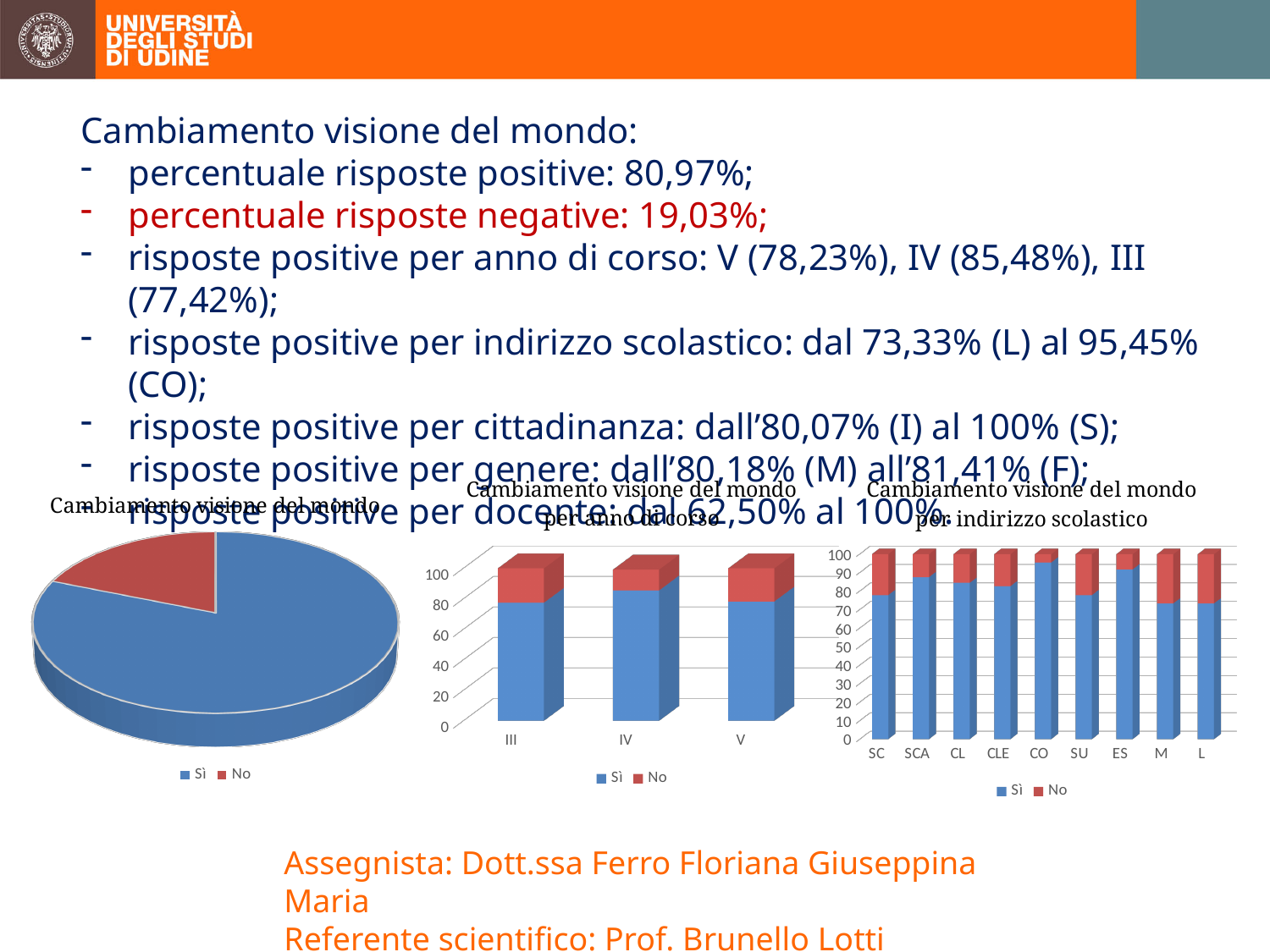
What kind of chart is the leftmost chart titled "Cambiamento visione del mondo"? pie chart In the middle chart "Cambiamento visione del mondo per anno di corso", is the Sì value for IV greater or less than 80? greater In the right chart "Cambiamento visione del mondo per indirizzo scolastico", is the Sì value for CO greater or less than 90? greater What are the two legend entries of the right chart "Cambiamento visione del mondo per indirizzo scolastico"? Sì and No In the middle chart "Cambiamento visione del mondo per anno di corso", which category has the highest Sì value? IV What kind of chart is the middle chart titled "Cambiamento visione del mondo per anno di corso"? bar chart In the right chart "Cambiamento visione del mondo per indirizzo scolastico", is the Sì value for L greater or less than 80? less How many series does the legend of the pie chart on the left list? 2 In the right chart "Cambiamento visione del mondo per indirizzo scolastico", how many categories are shown on the x axis? 9 In the pie chart on the left, which slice is larger, Sì or No? Sì In the middle chart "Cambiamento visione del mondo per anno di corso", how many categories are shown on the x axis? 3 In the right chart "Cambiamento visione del mondo per indirizzo scolastico", which category has the highest Sì value? CO